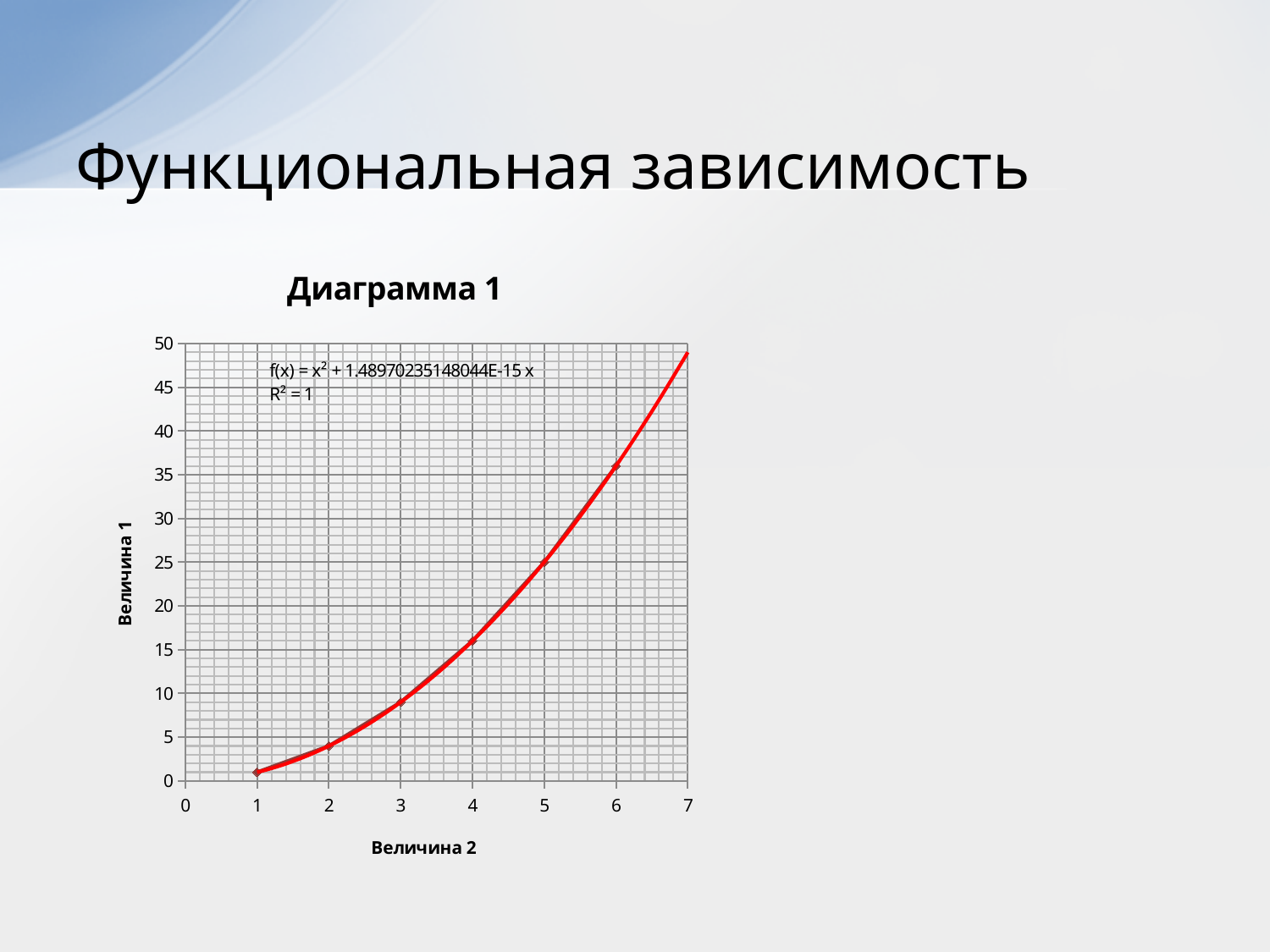
How many data points are plotted on the chart? 6 Is the value of Величина 1 at x = 4 greater or less than 20? less Which is larger: the value of Величина 1 at x = 6 or at x = 3? x = 6 Do the values rise or fall as Величина 2 increases along the x axis? rise What R² value is printed on the chart for the fitted trendline? R² = 1 At which x value (Величина 2) is the plotted value of Величина 1 lowest? 1 What is the title of the chart on the slide? Диаграмма 1 At which x value (Величина 2) is the plotted value of Величина 1 highest? 6 Is the value of Величина 1 at x = 5 greater or less than 20? greater What kind of chart is shown on the slide? scatter chart Is the value of Величина 1 at x = 1 greater or less than 5? less